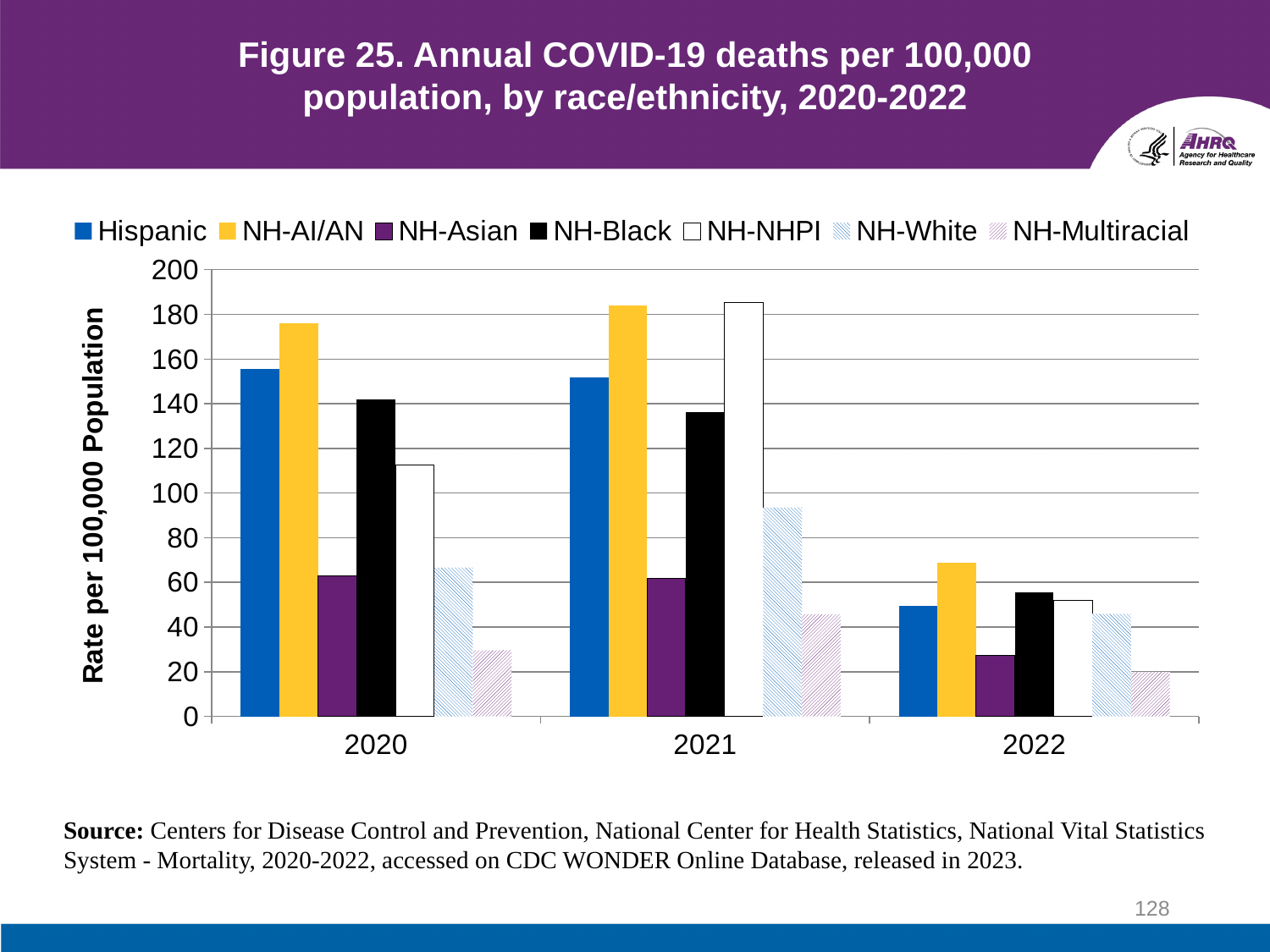
Which race/ethnicity group had the lowest COVID-19 death rate in 2021? NH-Multiracial Which race/ethnicity group had the highest COVID-19 death rate in 2022? NH-AI/AN What kind of chart is shown on the slide? bar chart How many years are shown on the x axis? 3 Which race/ethnicity group had the lowest COVID-19 death rate in 2020? NH-Multiracial In 2020, which is larger, the value for Hispanic or the value for NH-Black? Hispanic Is the value for Hispanic in 2022 greater or less than 60? less Is the value for NH-NHPI in 2020 greater or less than 100? greater Which race/ethnicity group had the highest COVID-19 death rate in 2020? NH-AI/AN How many series does the legend list? 7 Does the value for Hispanic rise or fall from 2020 to 2022? fall Is the value for NH-White in 2021 greater or less than 100? less